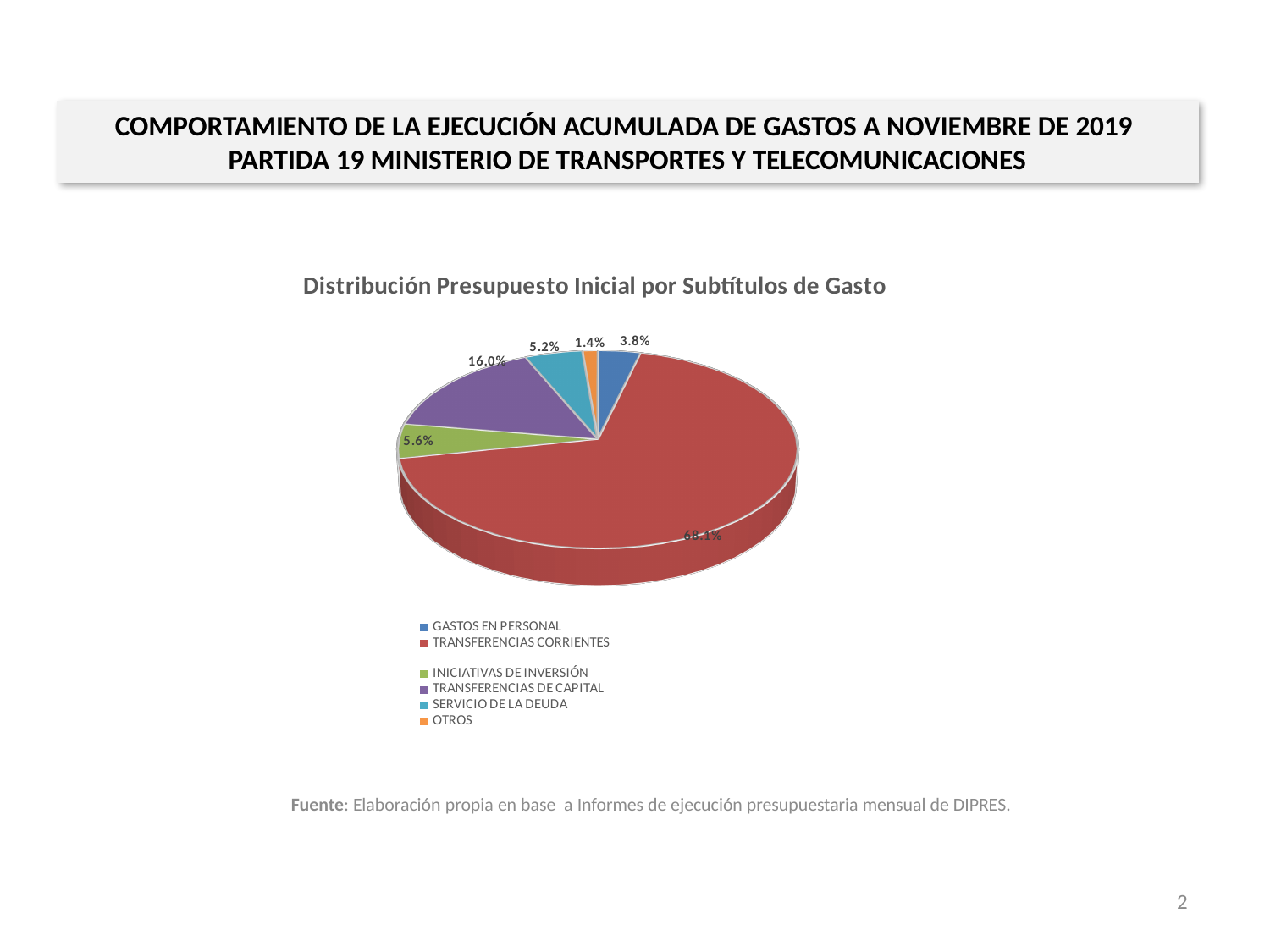
What is the value shown for GASTOS EN PERSONAL? 3.8% What is the value shown for SERVICIO DE LA DEUDA? 5.2% Which category has the smallest slice of the pie? OTROS Which category has the largest slice of the pie? TRANSFERENCIAS CORRIENTES What share of the pie does TRANSFERENCIAS DE CAPITAL represent? 16.0% What kind of chart is shown on the slide? Pie chart What is the title of the chart? Distribución Presupuesto Inicial por Subtítulos de Gasto What is the value shown for INICIATIVAS DE INVERSIÓN? 5.6% What share of the pie does TRANSFERENCIAS CORRIENTES represent? 68.1% How many categories does the legend of the pie chart list? 6 What is the difference between the shares of TRANSFERENCIAS DE CAPITAL and GASTOS EN PERSONAL? 12.2% Which is larger, the share for INICIATIVAS DE INVERSIÓN or the share for OTROS? INICIATIVAS DE INVERSIÓN